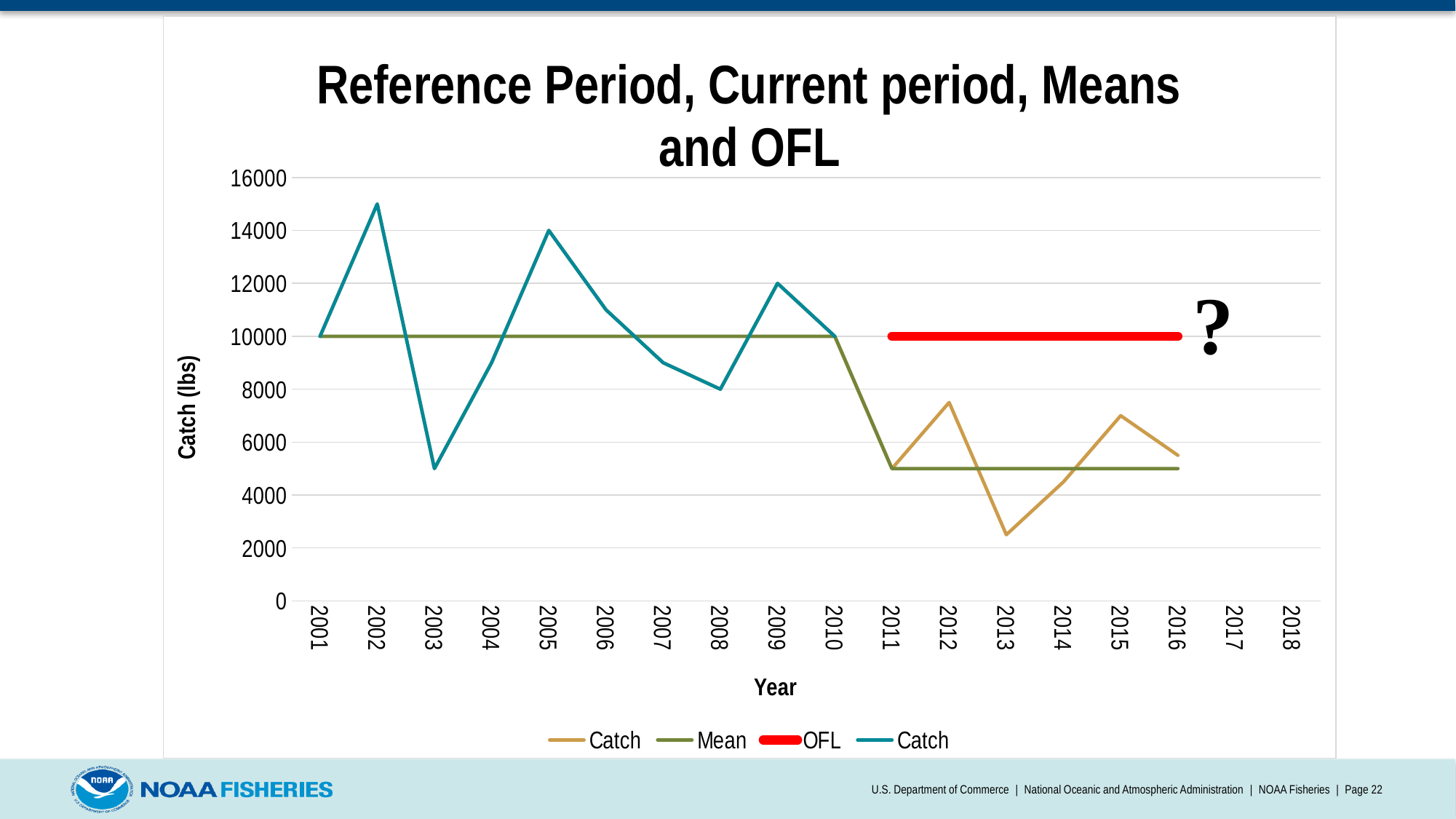
In which year is the catch lowest? 2013 What kind of chart is shown on the slide? line chart What is the catch value for 2005? 14000 Is the catch for 2013 greater or less than 4000? less What is the title of the y axis? Catch (lbs) Is the catch for 2002 greater or less than 14000? greater How many years are labelled on the x axis? 18 In which year is the catch highest? 2002 Which year has the larger catch, 2005 or 2009? 2005 How many series does the legend list? 4 What is the catch value for 2008? 8000 What is the OFL value shown by the red line? 10000